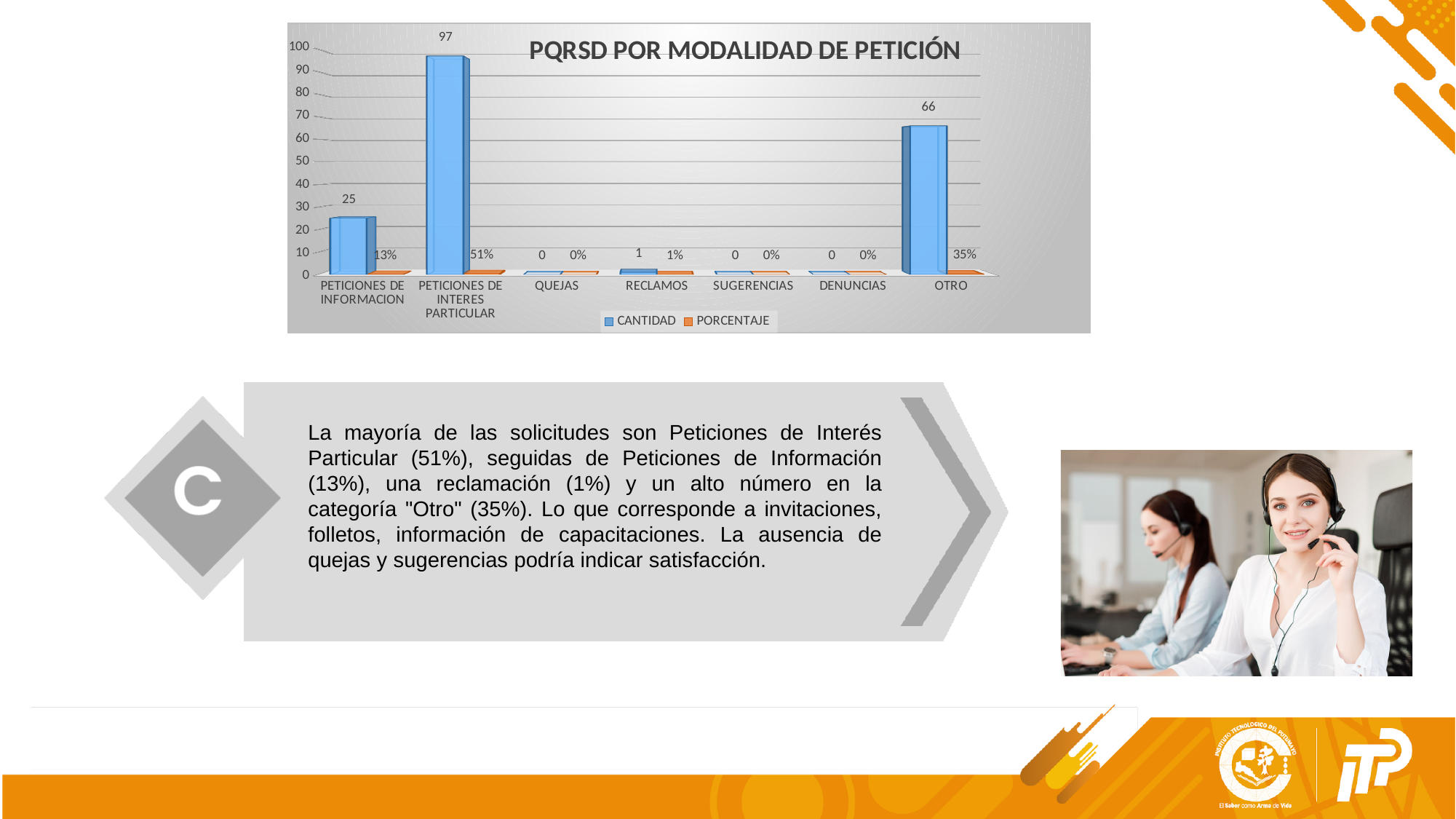
What PORCENTAJE is shown for PETICIONES DE INFORMACION? 13% What is the CANTIDAD value for RECLAMOS? 1 What kind of chart is shown on the slide? Bar chart What PORCENTAJE is shown for OTRO? 35% What is the CANTIDAD value for PETICIONES DE INTERES PARTICULAR? 97 What is the difference in CANTIDAD between PETICIONES DE INTERES PARTICULAR and OTRO? 31 Which category has the highest CANTIDAD? PETICIONES DE INTERES PARTICULAR How many categories are shown on the x axis? 7 What is the CANTIDAD value for OTRO? 66 Which has a larger CANTIDAD, PETICIONES DE INFORMACION or OTRO? OTRO What is the title of the chart? PQRSD POR MODALIDAD DE PETICIÓN How many series does the legend list? 2